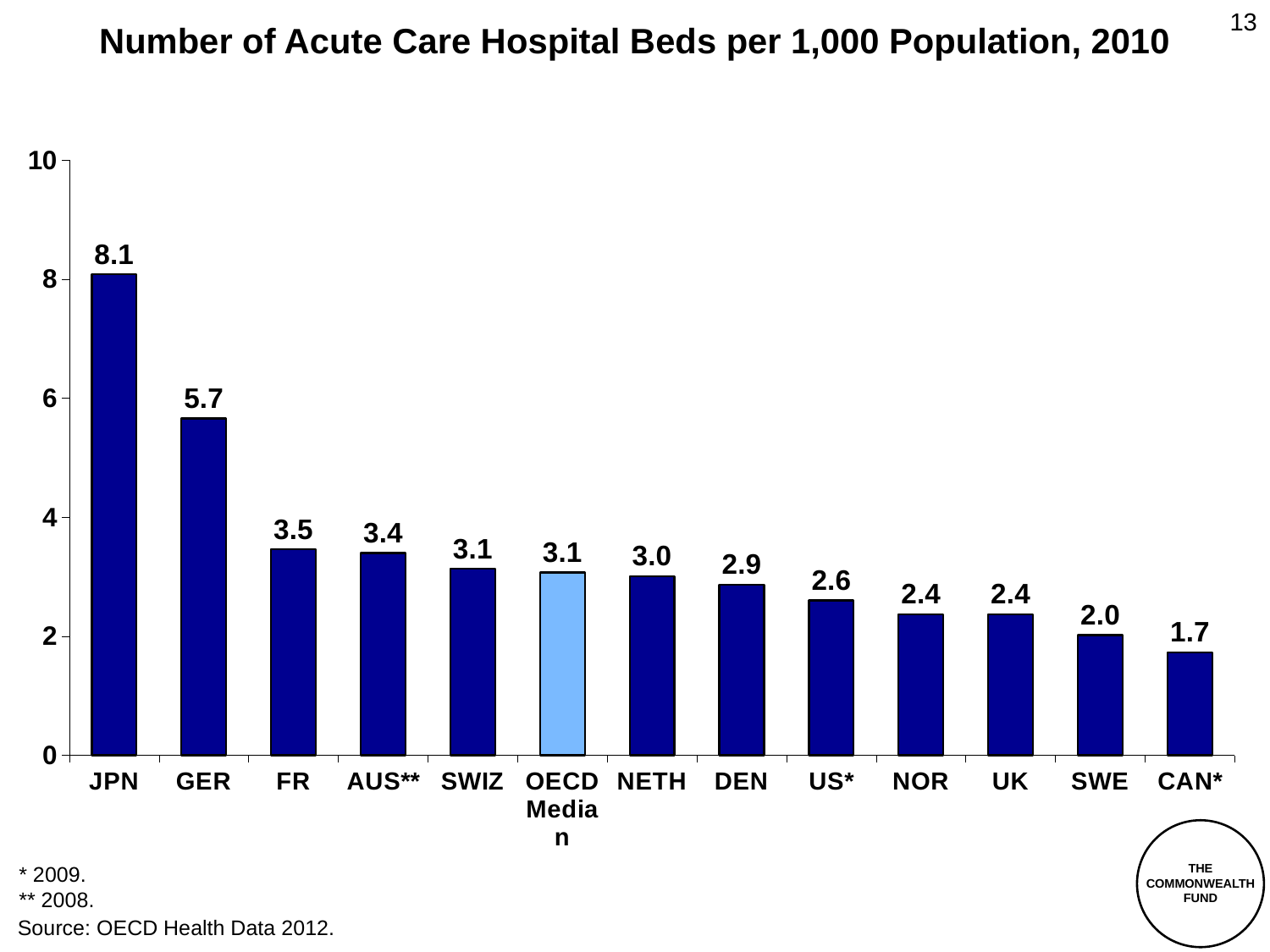
Is the value for GER greater or less than 4? greater What is the value shown for the OECD Median? 3.1 Which bar is shown in a lighter blue colour than the others? OECD Median What is the difference between the values for JPN and GER? 2.4 Which has a higher value, NETH or SWE? NETH How many bars are shown in the chart? 13 What is the value shown for US*? 2.6 Which country has the lowest number of acute care hospital beds per 1,000 population? CAN* What kind of chart is shown on the slide? Bar chart What is the difference between the values for FR and CAN*? 1.8 Which country has the highest number of acute care hospital beds per 1,000 population? JPN What is the number of acute care hospital beds per 1,000 population for JPN? 8.1